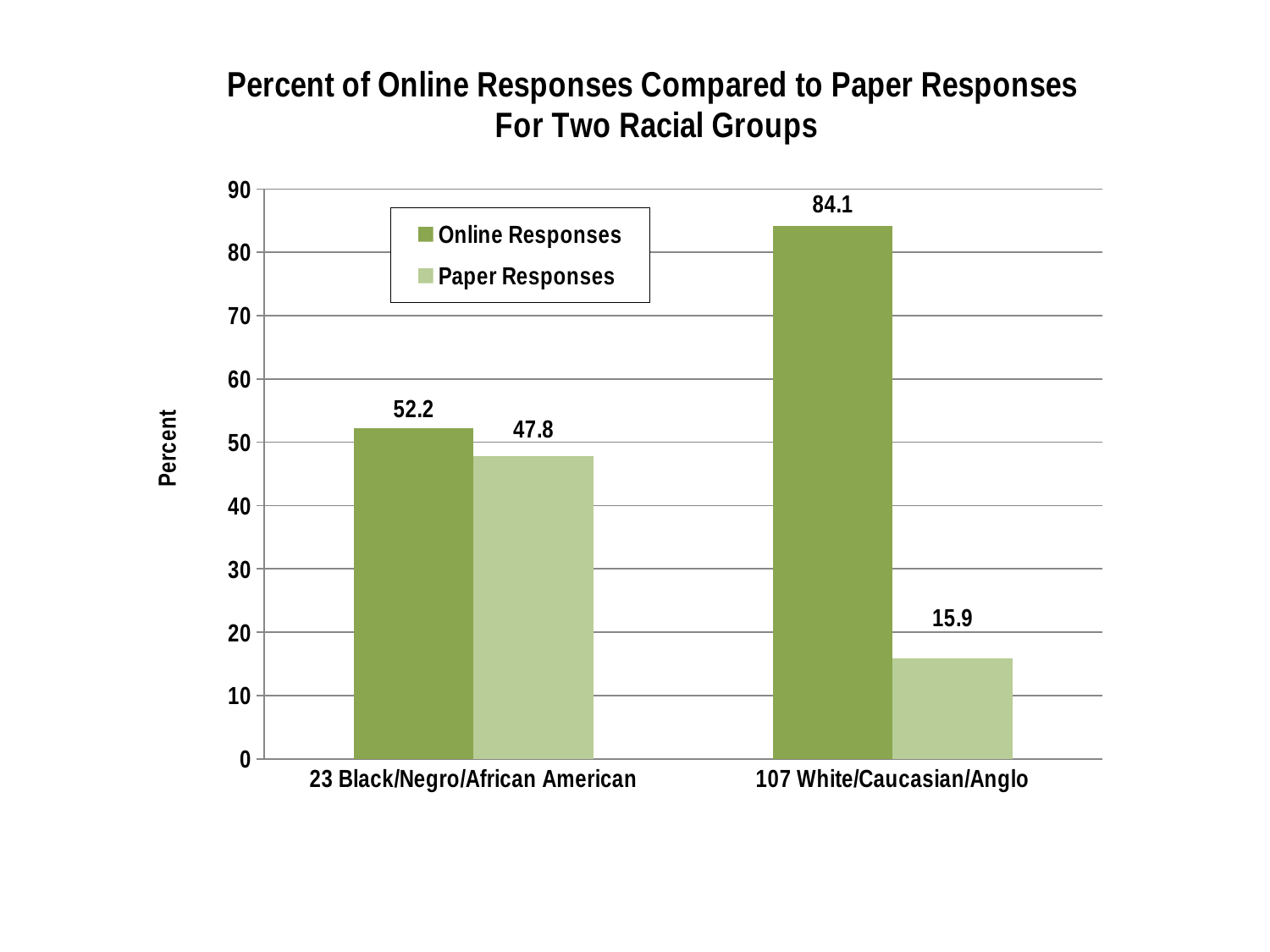
Which category has the lowest Paper Responses value? 107 White/Caucasian/Anglo What is the difference between Online Responses and Paper Responses for 107 White/Caucasian/Anglo? 68.2 What is the Paper Responses value for 23 Black/Negro/African American? 47.8 What is the Online Responses value for 23 Black/Negro/African American? 52.2 What is the difference between Online Responses and Paper Responses for 23 Black/Negro/African American? 4.4 What kind of chart is shown on the slide? bar chart Is the Online Responses value for 107 White/Caucasian/Anglo greater or less than 80? greater What is the Paper Responses value for 107 White/Caucasian/Anglo? 15.9 Which is larger: Online Responses for 107 White/Caucasian/Anglo or Online Responses for 23 Black/Negro/African American? Online Responses for 107 White/Caucasian/Anglo How many series does the legend list? 2 Which category has the highest Online Responses value? 107 White/Caucasian/Anglo How many categories are shown on the x axis? 2